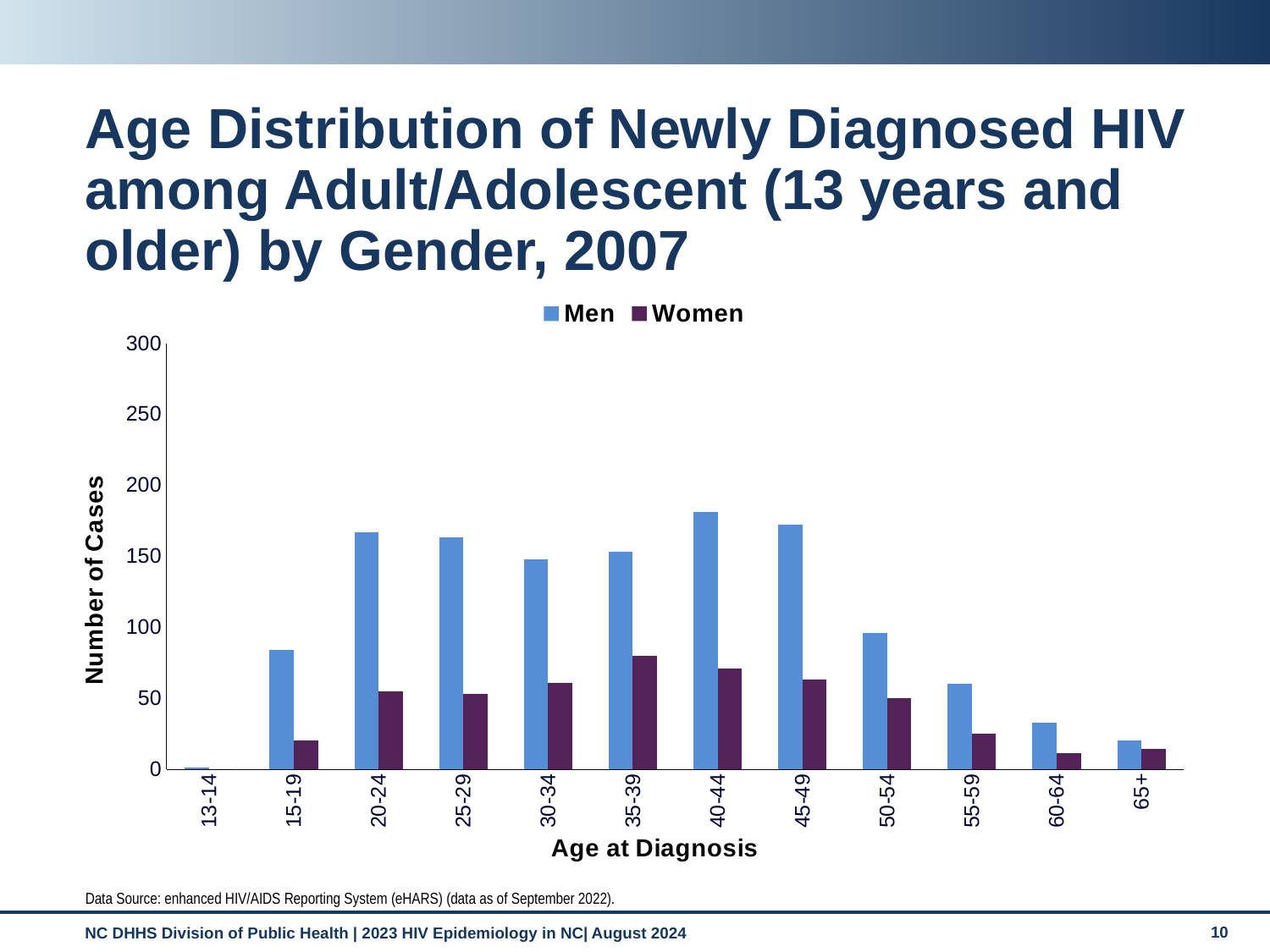
Is the value for Women in the 35-39 age group greater or less than 50? greater Which is larger: the number of cases for Men aged 20-24 or for Men aged 50-54? Men aged 20-24 Is the value for Men in the 40-44 age group greater or less than 150? greater How many series does the legend list? 2 Do the values for Men rise or fall across the age groups from 45-49 to 65+? fall What kind of chart is shown on the slide? bar chart What is the title of the x axis? Age at Diagnosis Is the value for Men in the 50-54 age group greater or less than 100? less Which age group has the highest number of cases for Men? 40-44 Which age group has the highest number of cases for Women? 35-39 Which age group has the lowest number of cases for Men? 13-14 How many age groups are shown on the x axis? 12